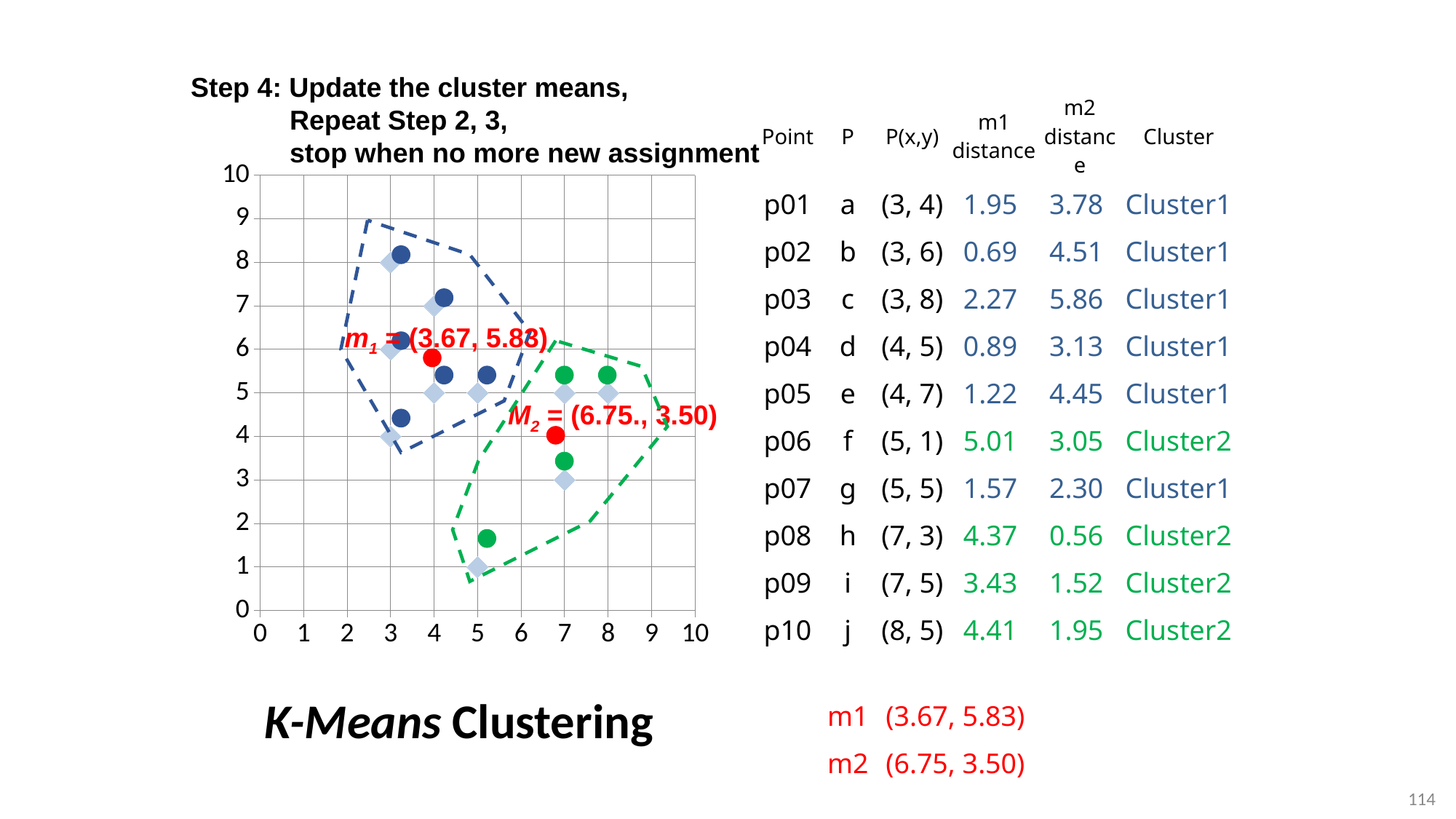
What are the coordinates of the cluster mean M2 shown on the chart? (6.75, 3.50) What is the difference between the x-coordinates of M2 and m1? 3.08 What is the difference between the y-coordinates of m1 and M2? 2.33 What kind of chart is shown on the slide? scatter chart What are the coordinates of the cluster mean m1 shown on the chart? (3.67, 5.83) How many green circle markers (Cluster2 points) are shown on the chart? 4 How many data points (light blue diamonds) are plotted on the chart? 10 How many dark blue circle markers (Cluster1 points) are shown on the chart? 6 Which cluster mean has the larger y-coordinate, m1 or M2? m1 Which cluster mean has the larger x-coordinate, m1 or M2? M2 What is the maximum value shown on the x axis of the chart? 10 What colour are the markers for the cluster means m1 and M2 on the chart? red